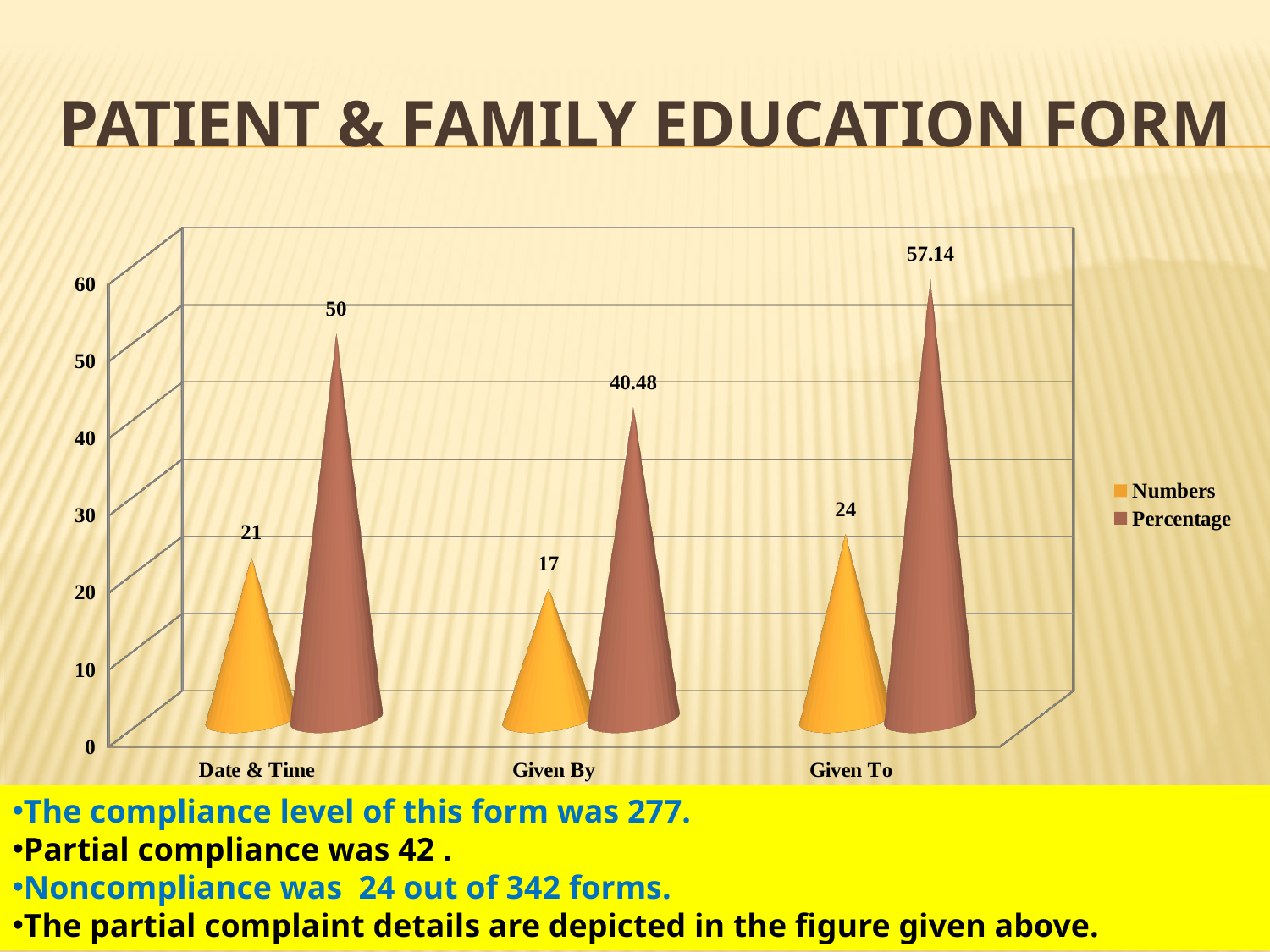
What is the Numbers value for Date & Time? 21 Which is larger, the Percentage value for Date & Time or for Given By? Date & Time Is the Percentage value for Given To greater or less than 50? greater Which category has the highest Percentage value? Given To How many series does the legend list? 2 Which series is shown in brown in the legend? Percentage How many categories are shown on the x axis? 3 What is the Percentage value for Given By? 40.48 What is the Percentage value for Given To? 57.14 What kind of chart is shown on the slide? bar chart What is the difference between the Numbers values for Given To and Given By? 7 Which category has the lowest Numbers value? Given By